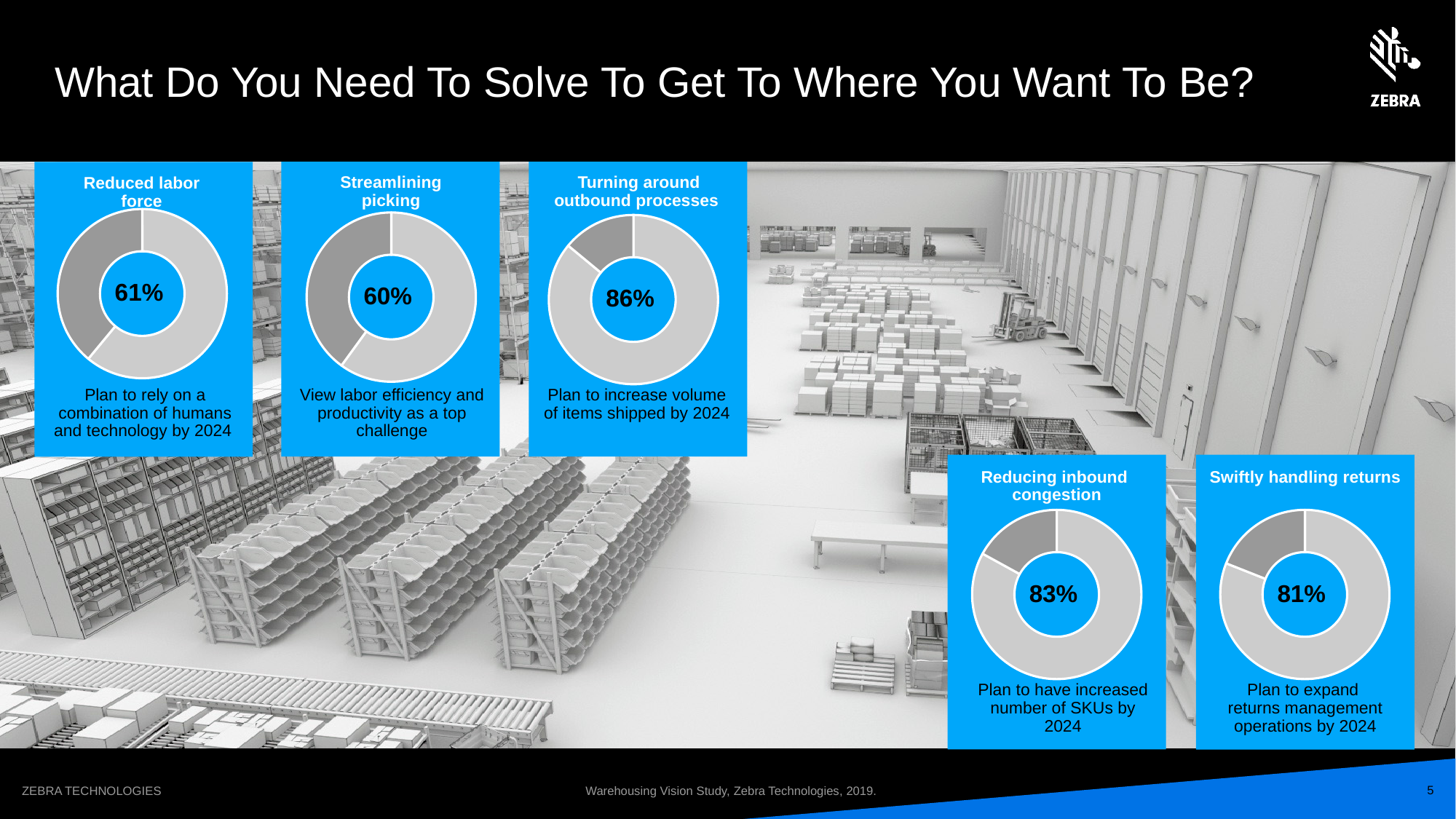
Across the five donut charts on the slide, which one shows the lowest percentage? Streamlining picking What is the difference between the percentage in the 'Turning around outbound processes' chart and the percentage in the 'Swiftly handling returns' chart? 5% In the 'Reduced labor force' chart, what percentage is shown in the centre of the donut? 61% In the 'Streamlining picking' chart, what percentage is shown? 60% Across the five donut charts on the slide, which one shows the highest percentage? Turning around outbound processes What is the title of the chart that shows 60%? Streamlining picking In the 'Turning around outbound processes' chart, what percentage plan to increase volume of items shipped by 2024? 86% Which shows a larger percentage: the 'Reducing inbound congestion' chart or the 'Reduced labor force' chart? Reducing inbound congestion In the 'Swiftly handling returns' chart, what percentage plan to expand returns management operations by 2024? 81% How many donut charts are shown on the slide? 5 What kind of chart is used in the 'Reduced labor force' panel? Donut chart In the 'Reducing inbound congestion' chart, what percentage plan to have increased number of SKUs by 2024? 83%